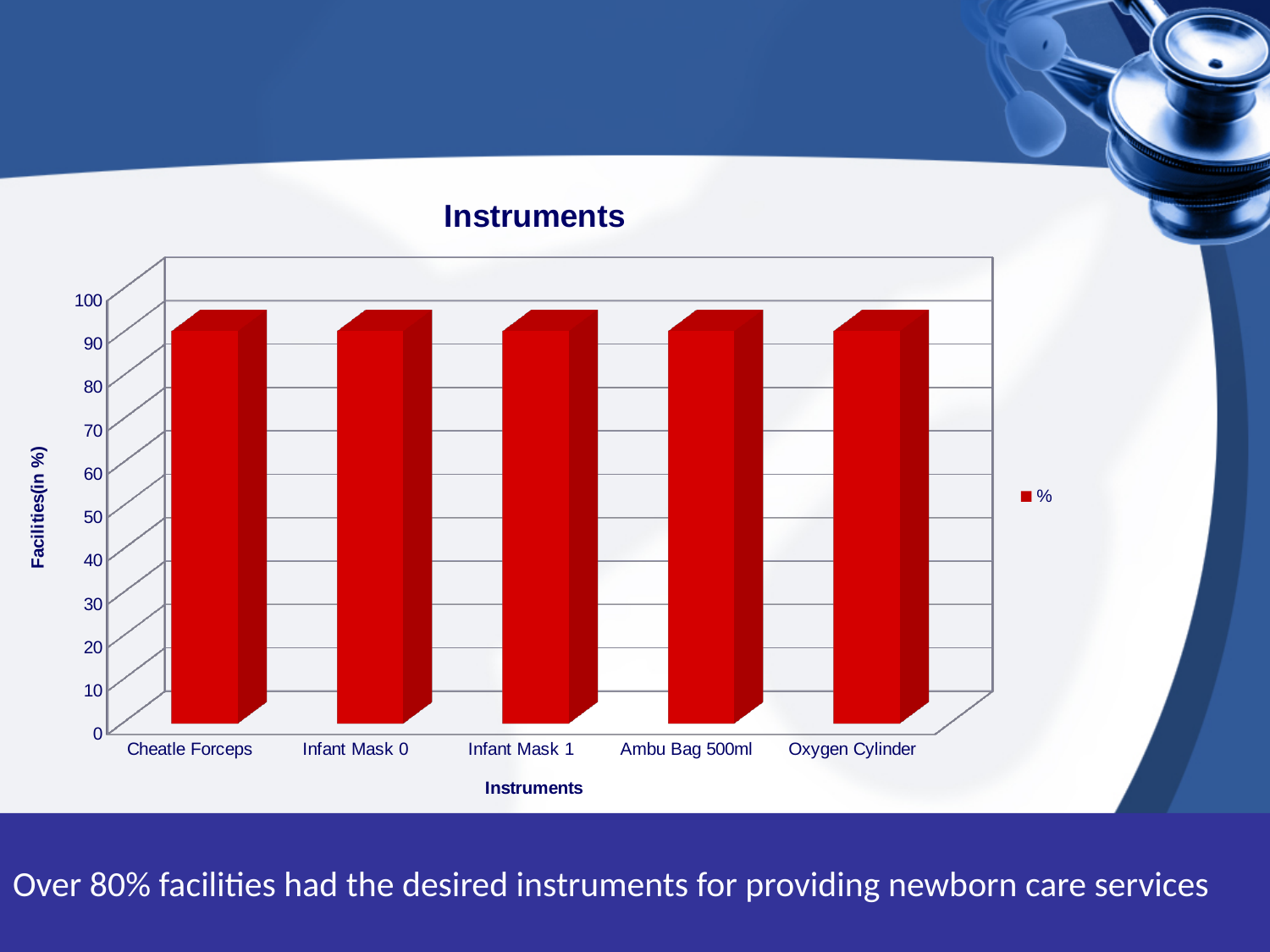
What kind of chart is shown on the slide? bar chart Is the value for Oxygen Cylinder greater or less than 100? less Is the value for Cheatle Forceps greater or less than 80? greater Is the value for Infant Mask 1 greater or less than 70? greater What is the title of the chart? Instruments What is the label on the vertical axis? Facilities(in %) How many instrument categories are plotted on the x axis? 5 Do the values rise, fall, or stay the same across the instruments from left to right? stay the same How many series does the legend list? 1